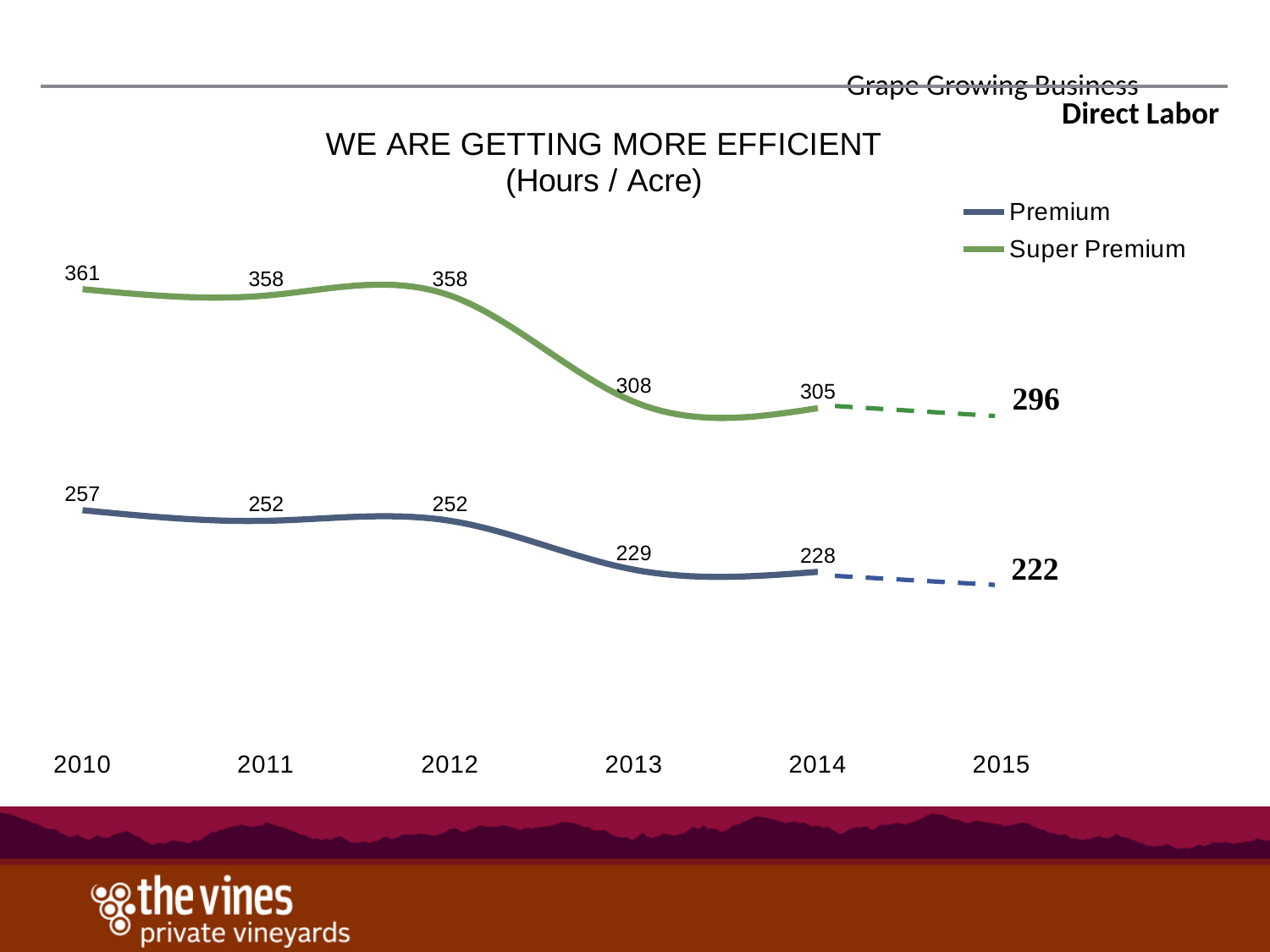
What kind of chart is shown on the slide? Line chart By how much does the Premium value fall from 2010 to 2014? 29 What is the projected Super Premium value for 2015? 296 What is the Premium value for 2013? 229 Which series has the higher value in 2012, Premium or Super Premium? Super Premium How many series does the legend list? 2 What is the Super Premium value (hours per acre) for 2010? 361 In which year is the Premium value lowest? 2015 In which year is the Super Premium value highest? 2010 How many years are shown on the x axis? 6 What is the difference between the Super Premium and Premium values in 2014? 77 What is the projected Premium value for 2015? 222